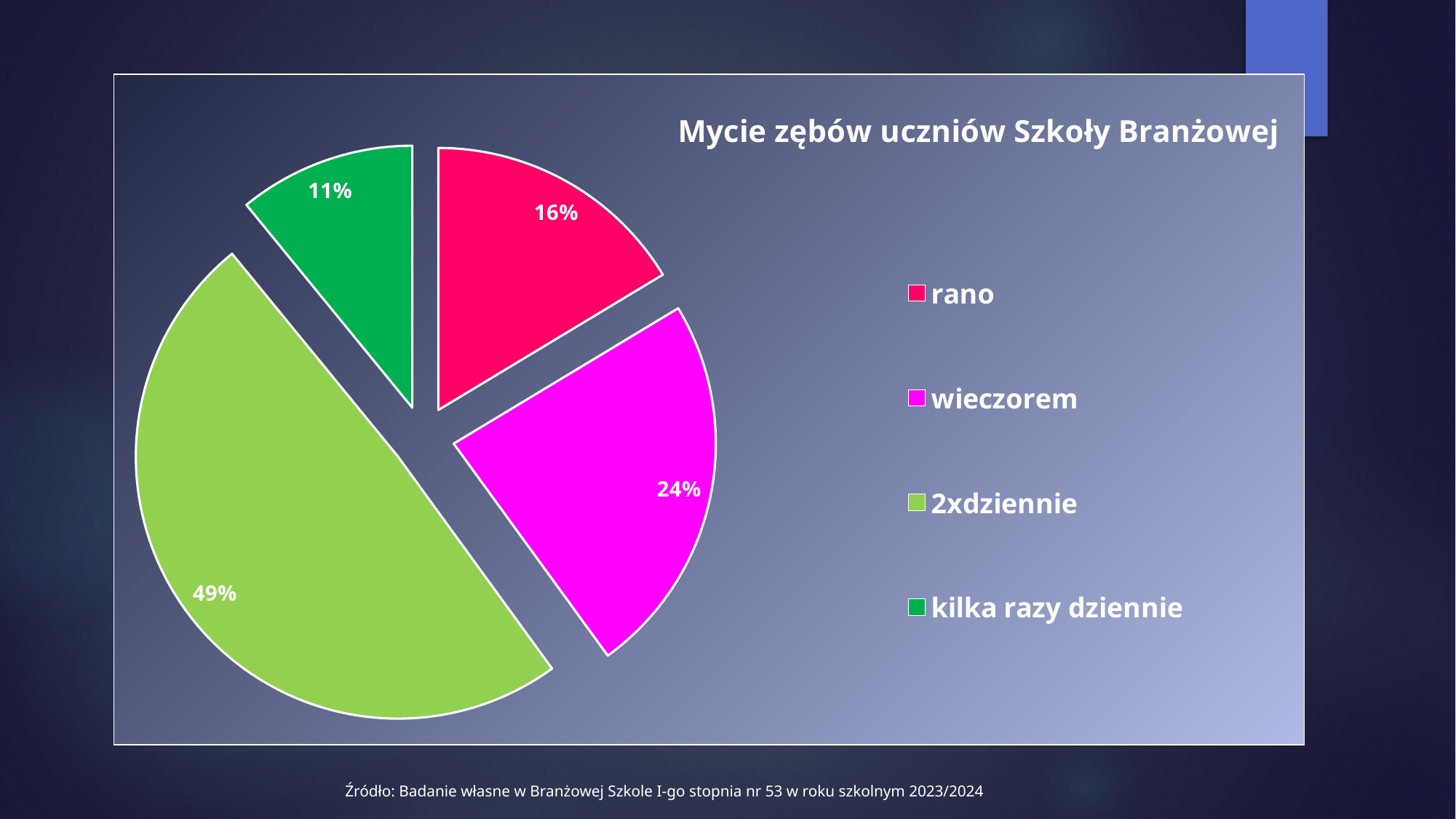
Which category has the largest slice of the pie? 2xdziennie How many categories does the legend list? 4 What percentage of the pie is labelled for 'rano'? 16% What percentage of the pie is labelled for '2xdziennie'? 49% What is the title of the chart? Mycie zębów uczniów Szkoły Branżowej Which is larger, the slice for 'rano' or the slice for 'wieczorem'? wieczorem What percentage of the pie is labelled for 'kilka razy dziennie'? 11% What type of chart is shown on the slide? pie chart What is the difference in percentage points between '2xdziennie' and 'wieczorem'? 25 What percentage of the pie is labelled for 'wieczorem'? 24% Which category has the smallest slice of the pie? kilka razy dziennie What colour is the slice for 'kilka razy dziennie'? green